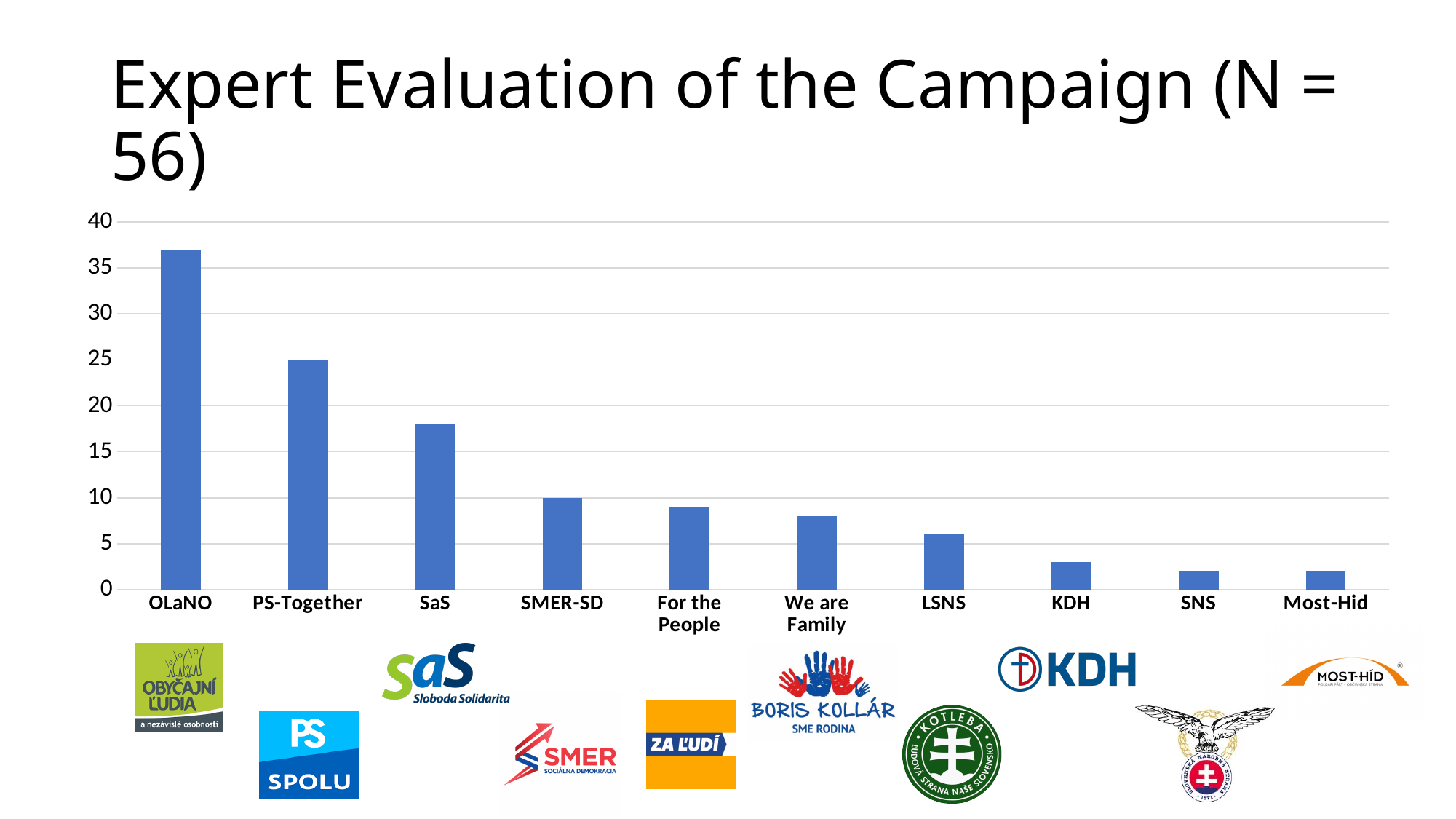
Is the value for OLaNO greater or less than 35? greater Which party has the highest value in the chart? OLaNO What is the title of the chart on the slide? Expert Evaluation of the Campaign (N = 56) Is the value for SaS greater or less than 20? less Which has a larger value, LSNS or KDH? LSNS How many parties (categories) are shown on the x axis of the chart? 10 What kind of chart is shown on the slide? bar chart Is the value for LSNS greater or less than 5? greater Which has a larger value, SaS or SMER-SD? SaS Do the values generally rise or fall moving from left to right along the x axis? fall